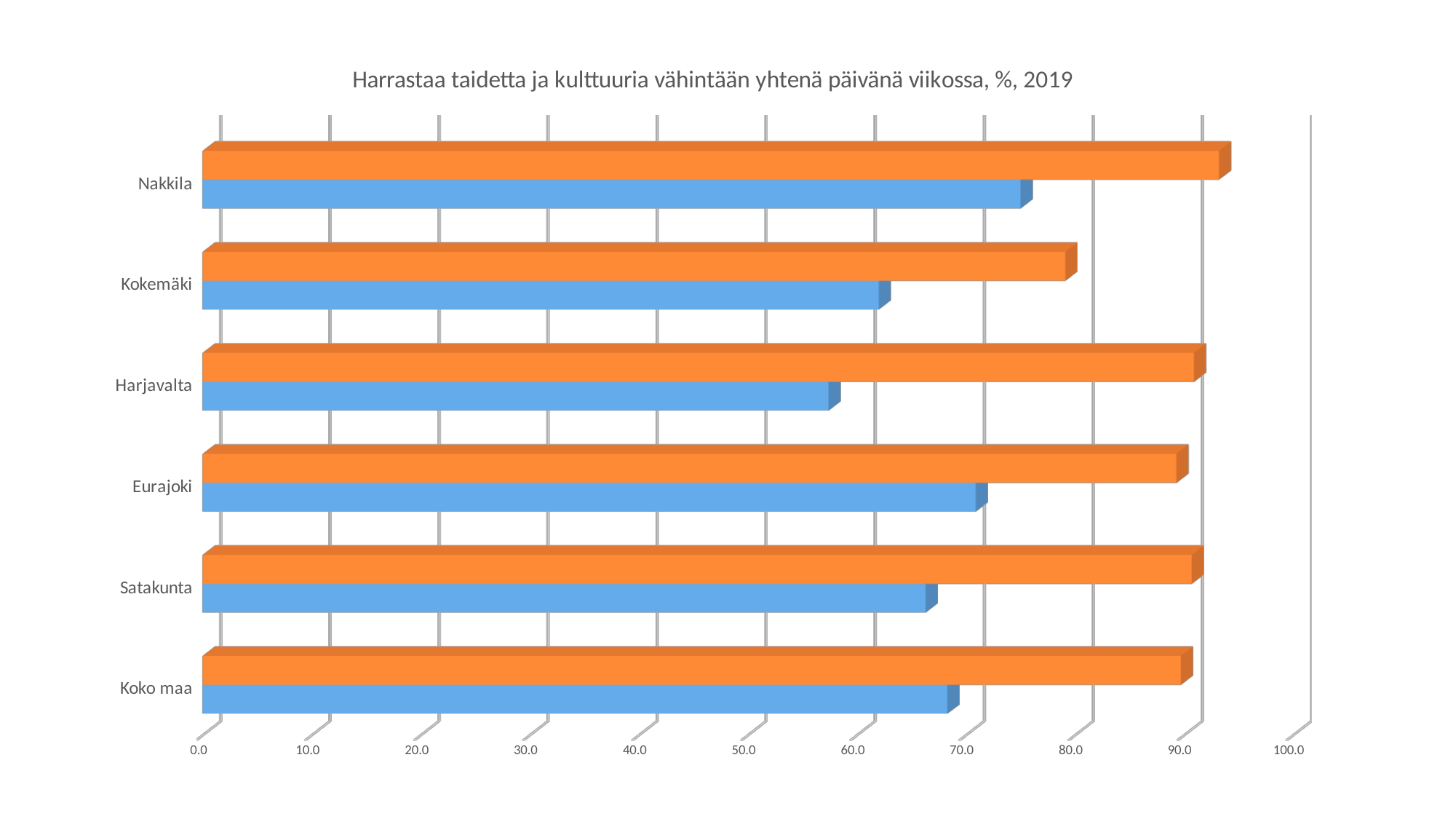
What is the title of the chart? Harrastaa taidetta ja kulttuuria vähintään yhtenä päivänä viikossa, %, 2019 Is the blue bar for Harjavalta greater or less than 60.0? less What kind of chart is shown on the slide? bar chart How many categories are shown on the vertical axis of the chart? 6 Is the blue bar for Satakunta greater or less than 70.0? less Which category has the shortest blue bar? Harjavalta Is the orange bar for Nakkila greater or less than 90.0? greater Which category has the longest orange bar? Nakkila Which category has the shortest orange bar? Kokemäki Which is larger for Kokemäki, the orange bar or the blue bar? the orange bar Which category has the longest blue bar? Nakkila